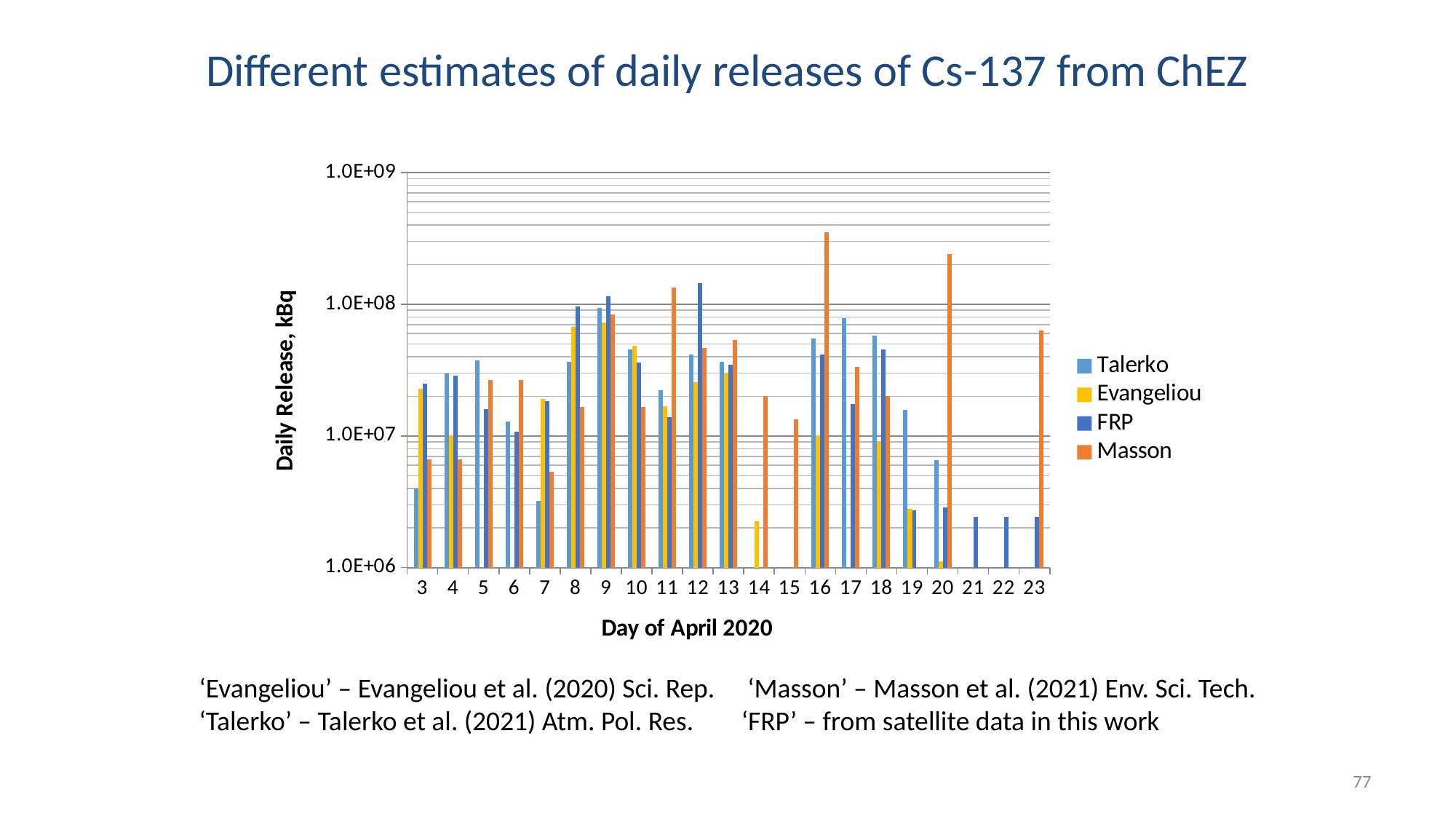
How many days are shown along the x axis? 21 On day 8, which is larger, the Talerko value or the FRP value? FRP What is the label of the x axis? Day of April 2020 On day 17, which is larger, the Talerko value or the FRP value? Talerko Is the Talerko value for day 3 greater or less than 1.0E+07? less What kind of chart is shown on the slide? bar chart Is the Masson value for day 16 greater or less than 1.0E+08? greater Which series has the highest value on day 16? Masson How many series does the legend list? 4 What is the label of the y axis? Daily Release, kBq Is the FRP value for day 12 greater or less than 1.0E+08? greater